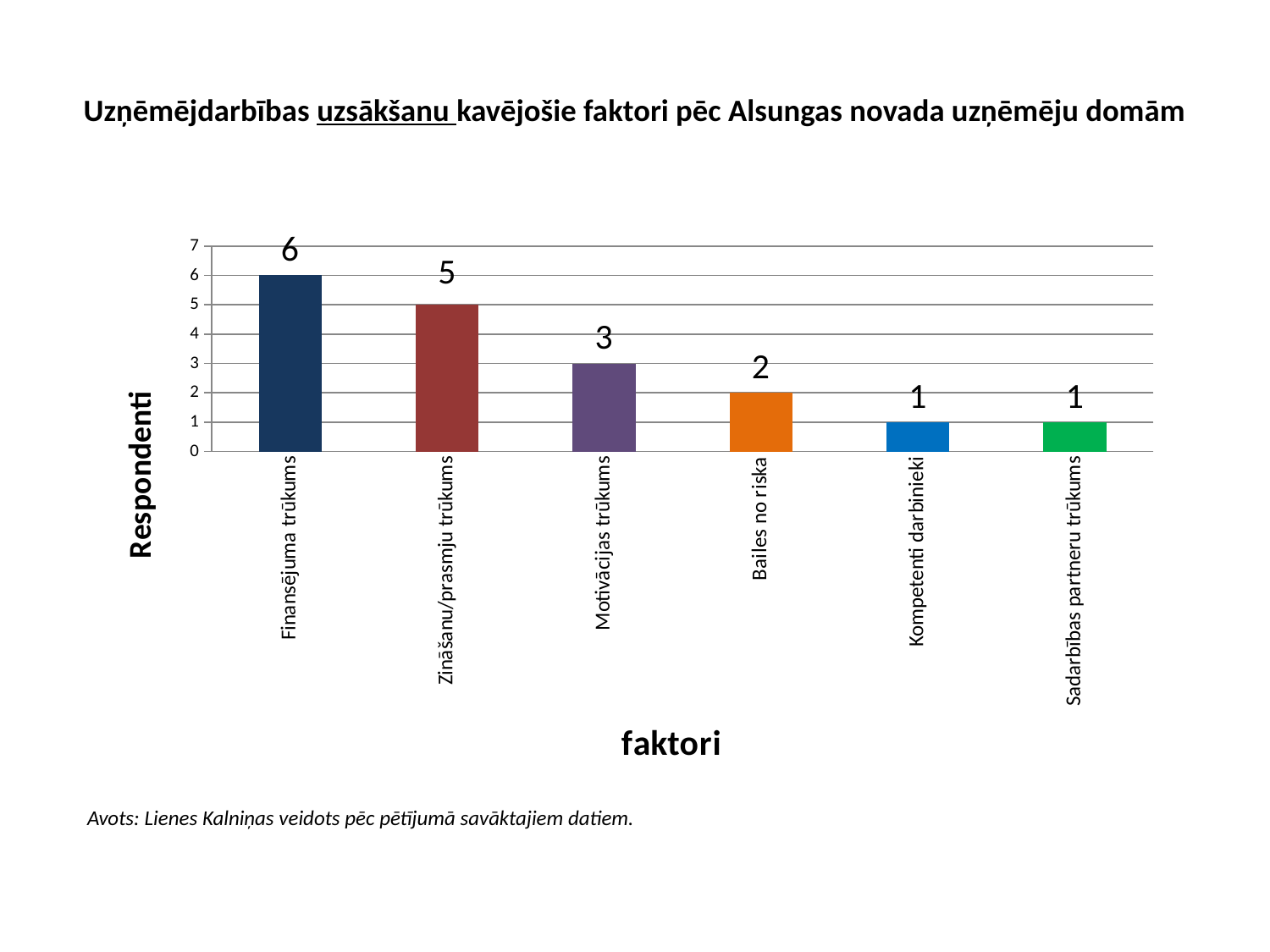
Which is larger, the value for Motivācijas trūkums or the value for Bailes no riska? Motivācijas trūkums Which category has the highest value? Finansējuma trūkums Do the values rise or fall from left to right along the x axis? Fall What kind of chart is shown on the slide? Bar chart What is the label of the y axis? Respondenti What is the difference between the values for Zināšanu/prasmju trūkums and Bailes no riska? 3 How many categories are shown on the x axis? 6 What is the value for Motivācijas trūkums? 3 What is the value for Bailes no riska? 2 What is the value for Finansējuma trūkums? 6 What is the value for Zināšanu/prasmju trūkums? 5 What is the difference between the values for Finansējuma trūkums and Motivācijas trūkums? 3